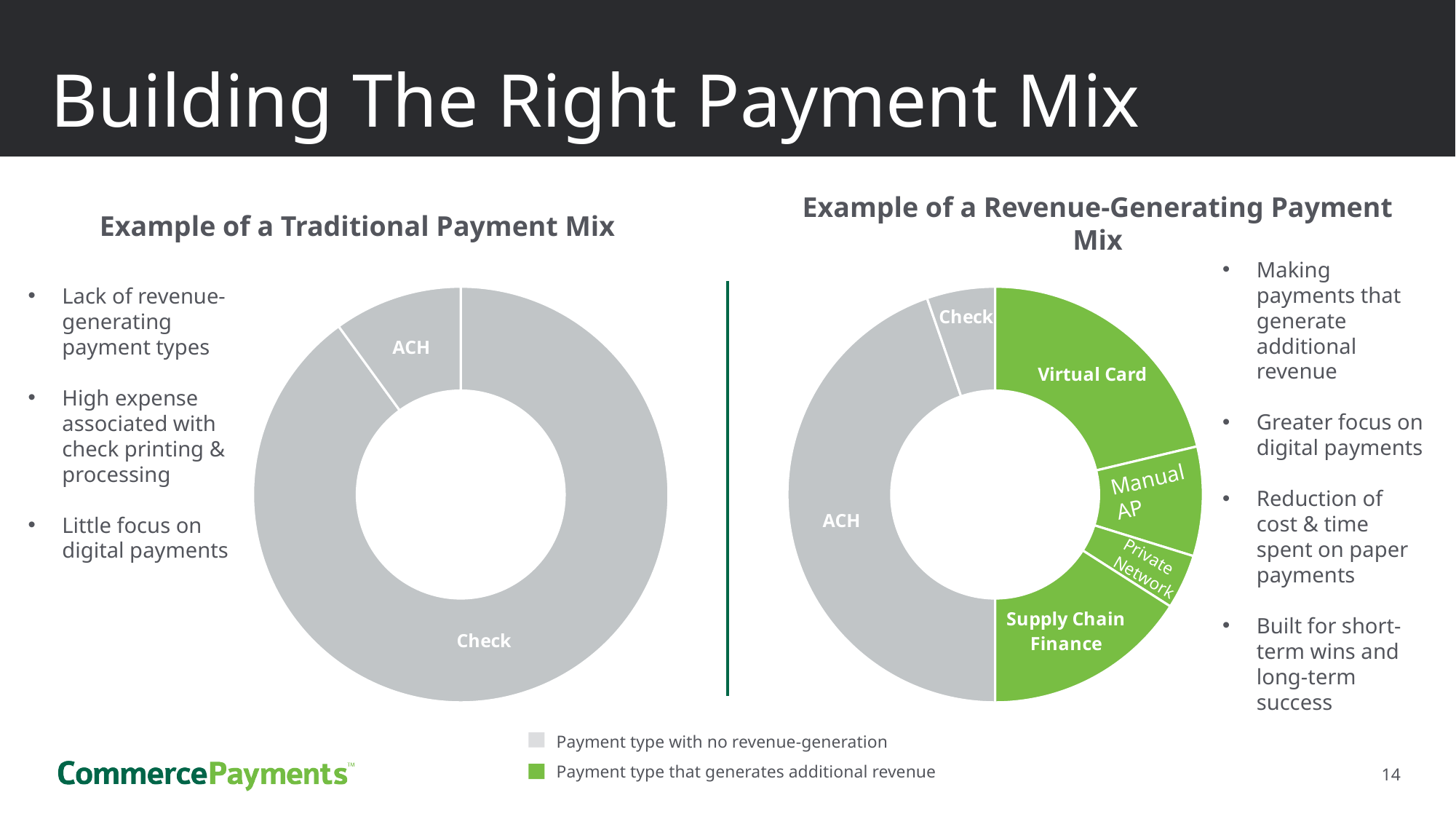
According to the legend, what does the grey colour represent? Payment type with no revenue-generation How many entries does the legend at the bottom of the slide list? 2 In the 'Example of a Revenue-Generating Payment Mix' chart, how many segments are coloured green (payment types that generate additional revenue)? 4 What kind of chart is the 'Example of a Traditional Payment Mix' chart? donut chart In the 'Example of a Revenue-Generating Payment Mix' chart, which is larger, ACH or Virtual Card? ACH In the 'Example of a Revenue-Generating Payment Mix' chart, which payment type has the largest share? ACH How many segments does the 'Example of a Traditional Payment Mix' chart have? 2 In the 'Example of a Traditional Payment Mix' chart, which payment type has the smallest share? ACH In the 'Example of a Revenue-Generating Payment Mix' chart, which is larger, Virtual Card or Manual AP? Virtual Card How many segments does the 'Example of a Revenue-Generating Payment Mix' chart have? 6 In the 'Example of a Traditional Payment Mix' chart, which payment type has the largest share? Check In the 'Example of a Revenue-Generating Payment Mix' chart, which is larger, Supply Chain Finance or Private Network? Supply Chain Finance